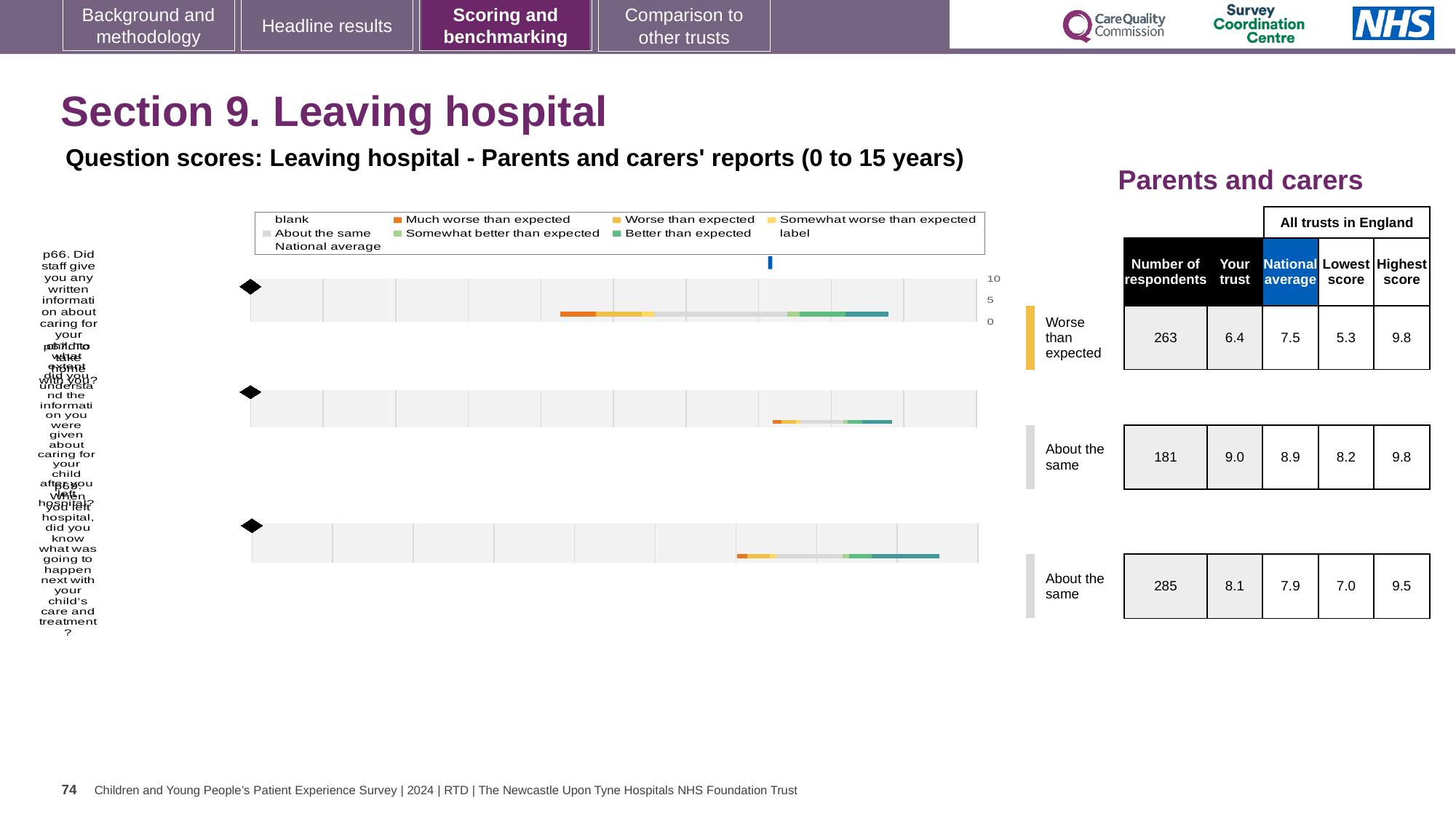
What kind of chart is used to show the question scores on this slide? bar chart For the middle chart, how many respondents are shown in the table? 181 For the top chart (p66), what is the difference between the highest score (9.8) and the lowest score (5.3)? 4.5 For the middle chart, what is the difference between the 'Your trust' score (9.0) and the national average (8.9)? 0.1 For the top chart (p66), is the 'Your trust' score or the national average score larger? National average What is the benchmark category shown for the top chart (p66, written information about caring for your child)? Worse than expected For the bottom chart, what is the highest score across all trusts in England? 9.5 How many question bars (rows) are plotted in the benchmark charts on this slide? 3 For the top chart (p66), what is the national average score? 7.5 For the top chart (p66), what is the 'Your trust' score shown in the table? 6.4 In the chart legend, what colour represents 'Much worse than expected'? orange Which of the three charts has the highest number of respondents? the bottom chart (285)